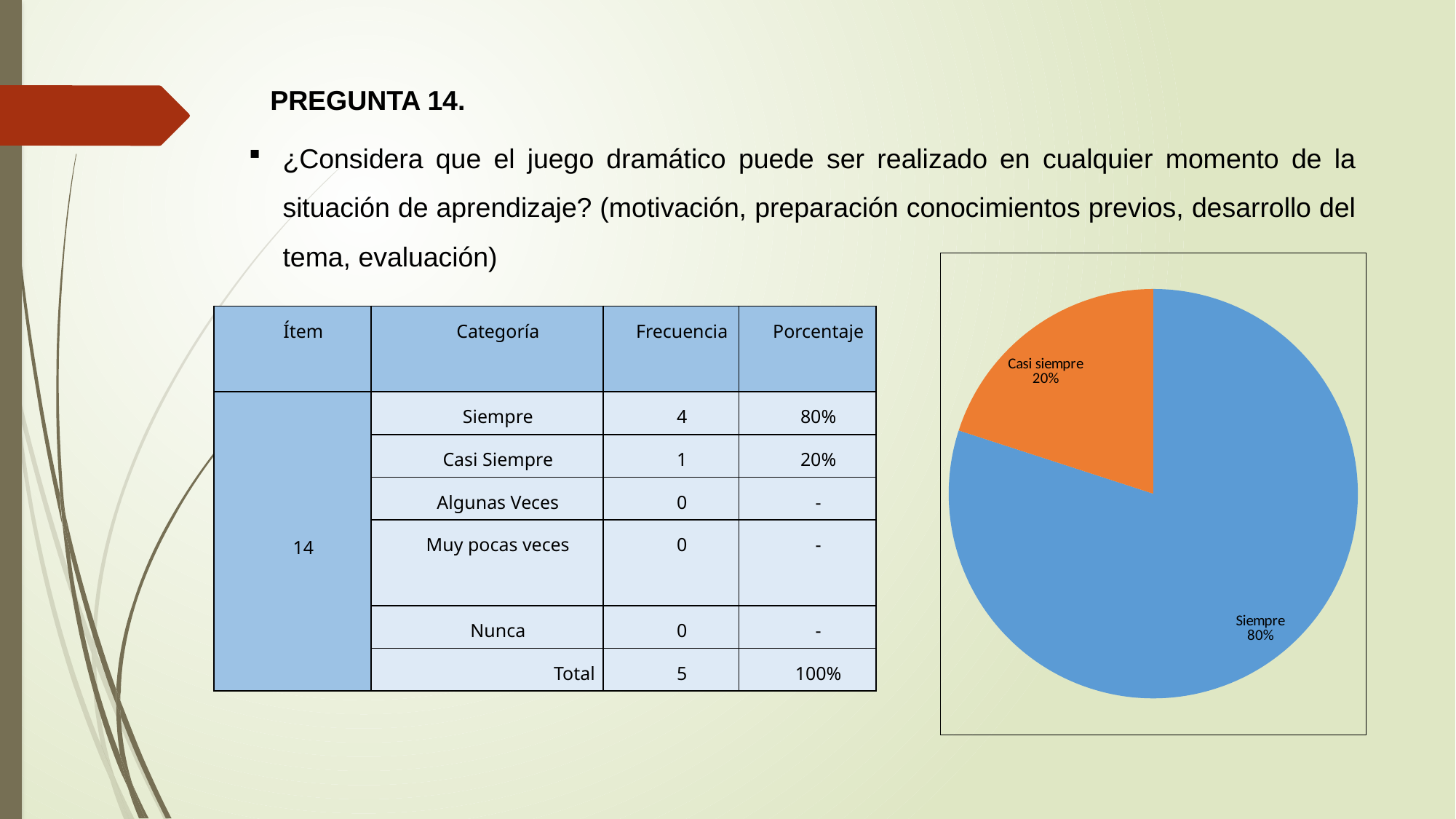
Which slice of the pie chart is the smallest? Casi siempre What colour is the "Siempre" slice in the pie chart? blue What kind of chart is shown on the slide? pie chart What share of the pie does the "Siempre" slice represent? 80% Which slice of the pie chart is the largest? Siempre How many slices does the pie chart have? 2 What colour is the "Casi siempre" slice in the pie chart? orange Which is larger in the pie chart, "Siempre" or "Casi siempre"? Siempre What is the difference in percentage points between the "Siempre" and "Casi siempre" slices? 60% What share of the pie does the "Casi siempre" slice represent? 20%